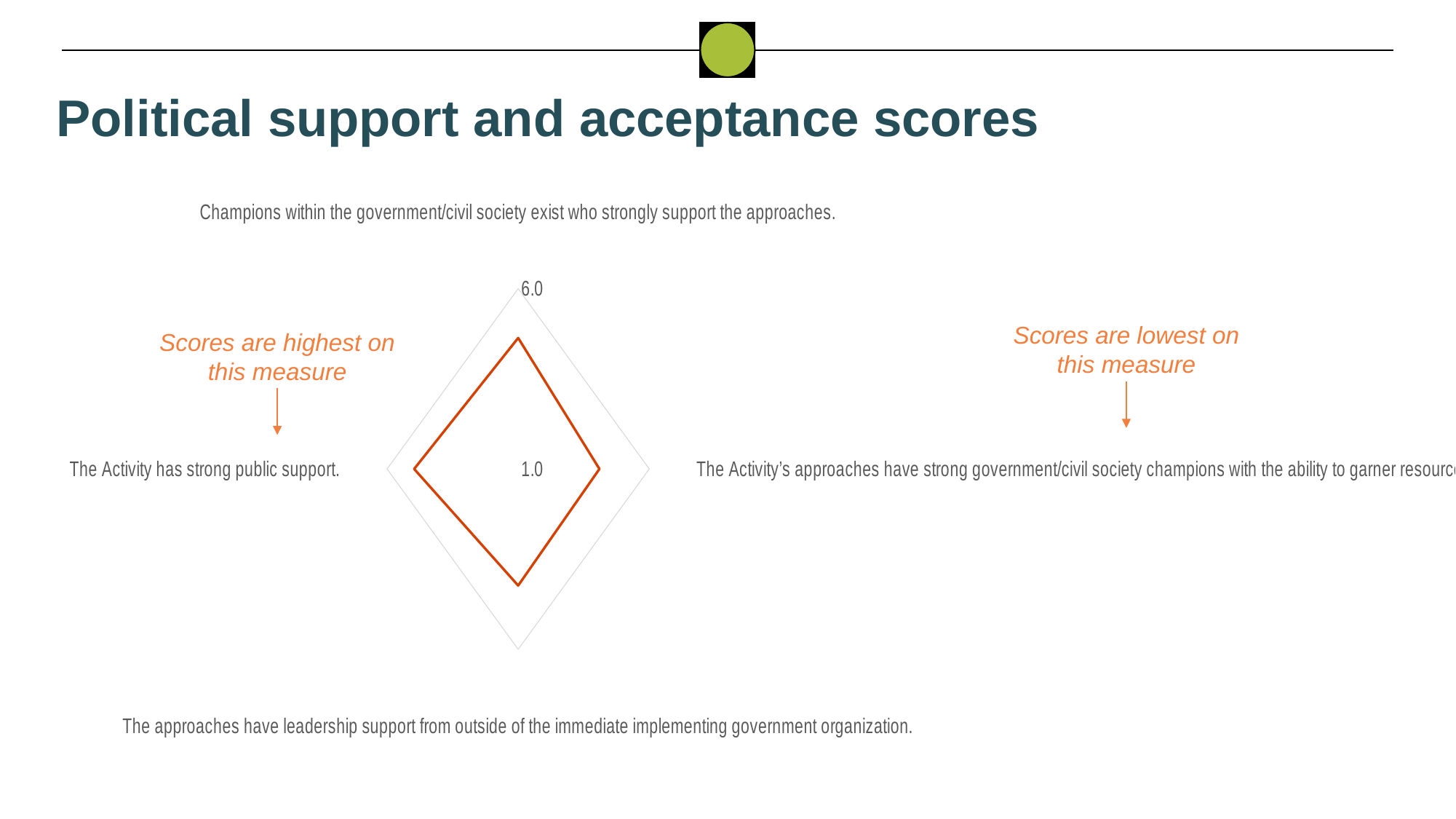
On which measure is the score highest according to the chart? The Activity has strong public support. How many measures (axes) does the radar chart plot? 4 Is the score for 'The Activity has strong public support' greater or less than 1.0? greater Is the score for 'The approaches have leadership support from outside of the immediate implementing government organization' greater or less than 1.0? greater Is the score for 'Champions within the government/civil society exist who strongly support the approaches' greater or less than 6.0? less On which measure is the score lowest according to the chart? The measure on the right: the Activity's approaches have strong government/civil society champions What is the maximum value shown on the radar chart's scale? 6.0 What kind of chart is shown on the slide? Radar chart What value is labelled at the centre of the radar chart? 1.0 Which has the larger score: 'The Activity has strong public support' or the measure on the right side of the chart? The Activity has strong public support.